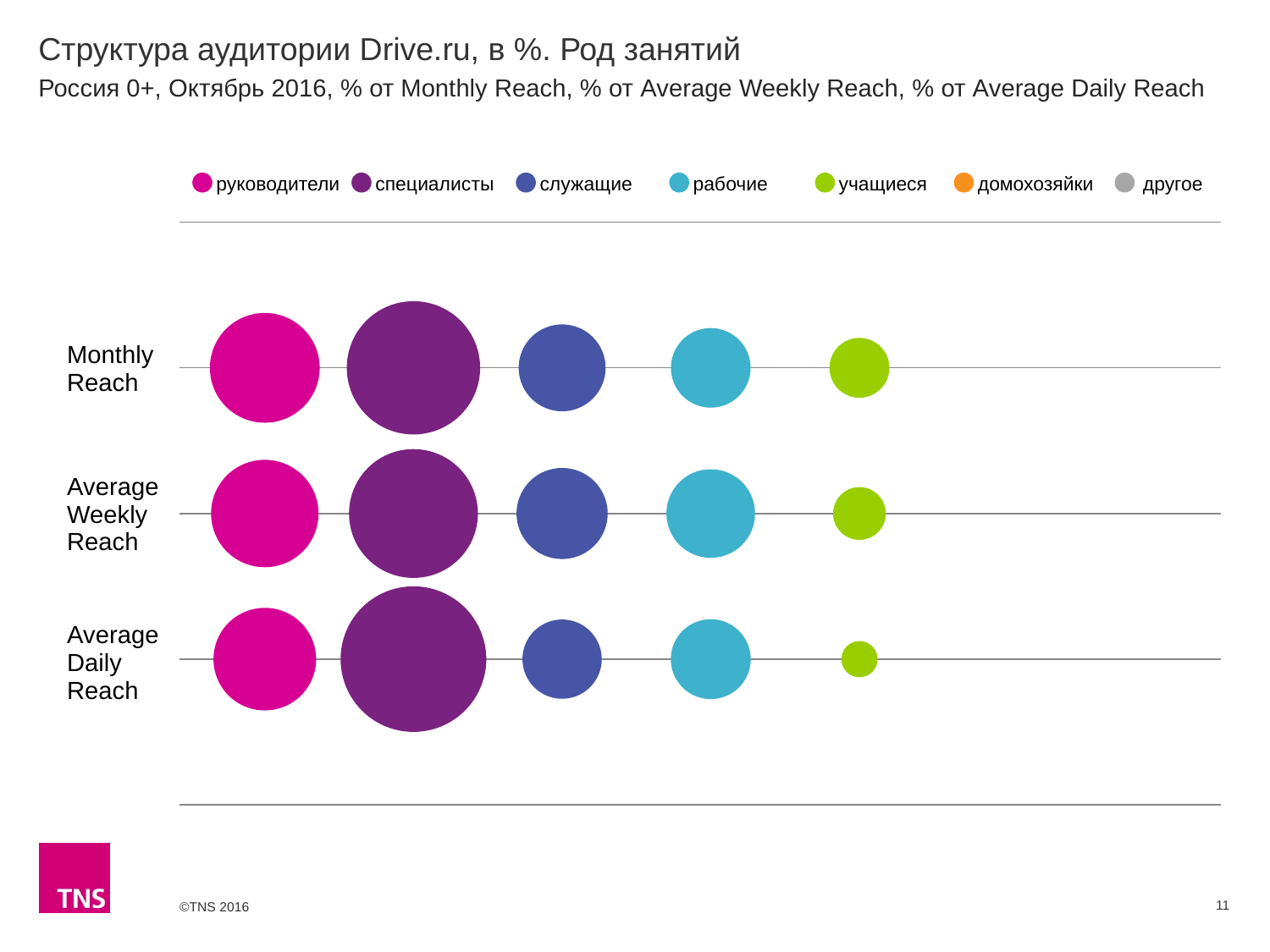
What kind of chart is shown on the slide? Bubble chart How many occupation categories does the legend list? 7 How many bubbles are visible in the Monthly Reach row? 5 In the Average Weekly Reach row, which bubble is larger: руководители or служащие? руководители What colour is the bubble for специалисты? Purple Which website's audience structure does the chart title refer to? Drive.ru Does the bubble for учащиеся get larger or smaller going from Monthly Reach to Average Daily Reach? smaller Which occupation group has the largest bubble in the Monthly Reach row? специалисты In the Monthly Reach row, which bubble is larger: специалисты or рабочие? специалисты How many reach rows (categories on the vertical axis) are plotted in the chart? 3 Among the visible bubbles in the Average Daily Reach row, which occupation group has the smallest? учащиеся Which occupation group has the largest bubble in the Average Daily Reach row? специалисты